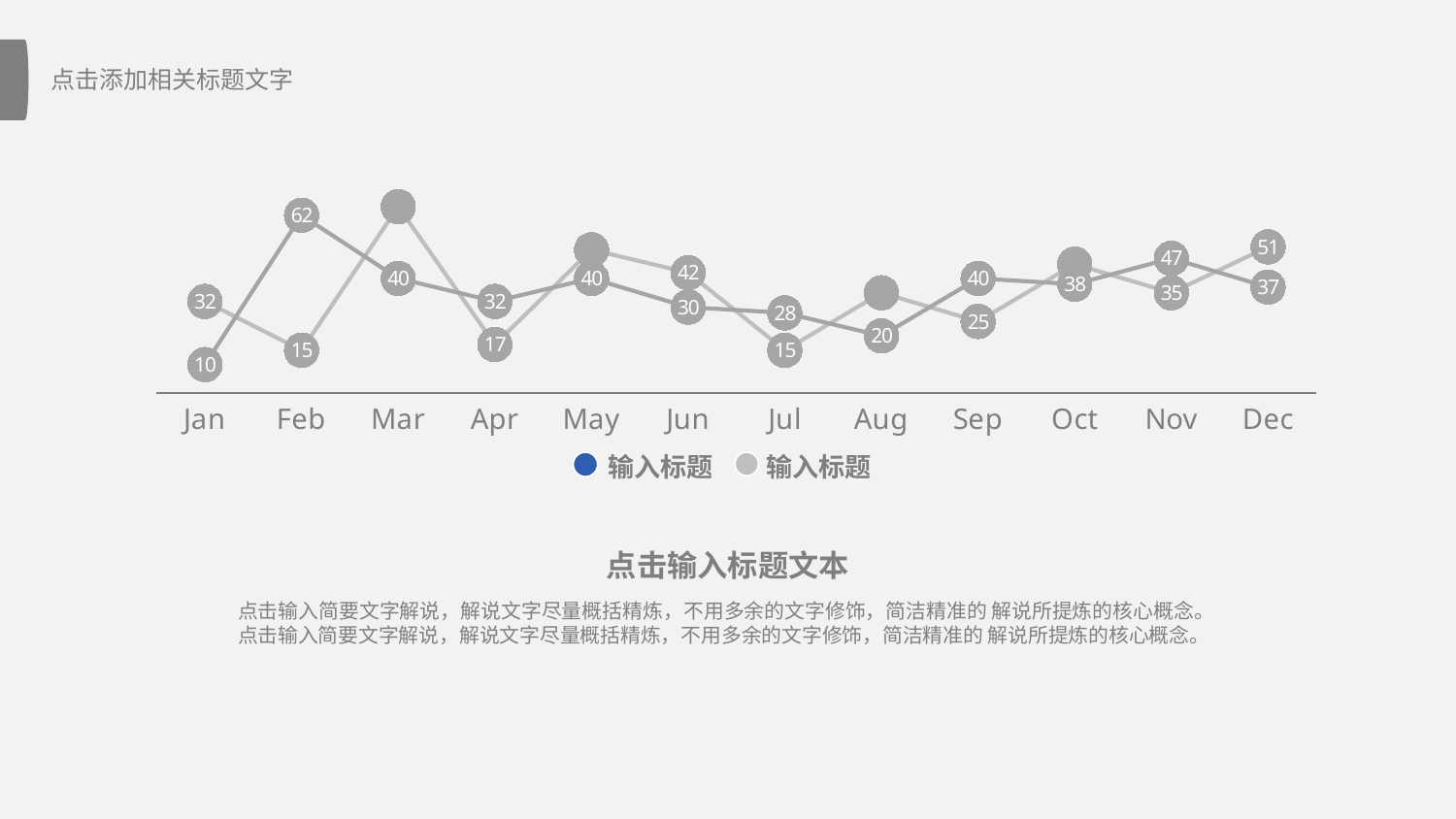
What text is used for both legend entries of the chart? 输入标题 What kind of chart is shown on the slide? line chart What are the two data labels shown for Dec? 51 and 37 What are the two data labels shown for Jan? 32 and 10 How many series does the chart legend list? 2 Which month has the lowest value on the chart? Jan What is the lower of the two values labeled at Feb? 15 What is the difference between the two values labeled at Feb (62 and 15)? 47 What is the higher of the two values labeled at Feb? 62 What is the largest data label printed on the chart? 62 How many months are shown along the x axis of the chart? 12 At Jun, which of the two labeled values is larger, 42 or 30? 42